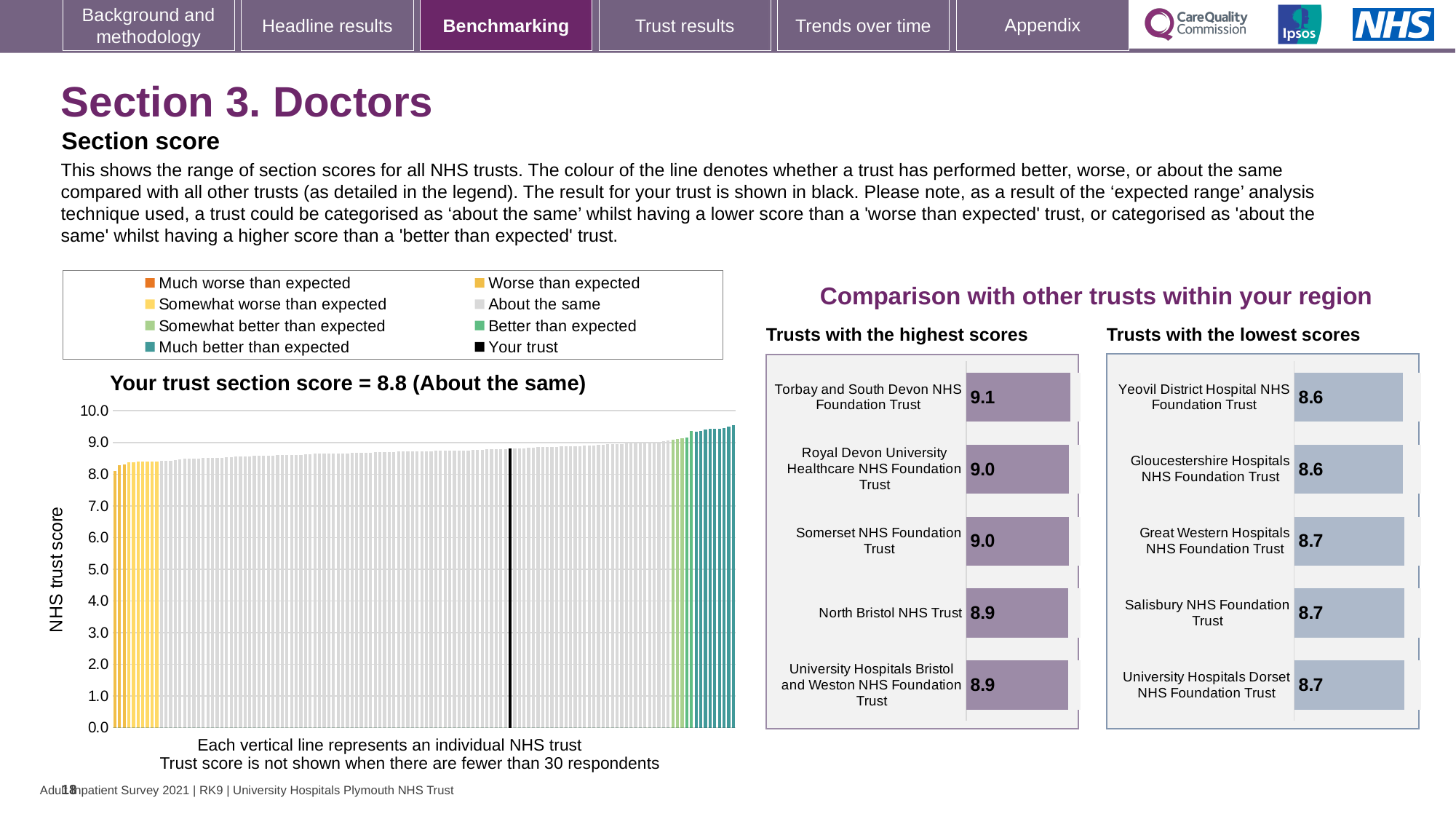
On the 'Trusts with the lowest scores' chart, which is larger, the score for Great Western Hospitals NHS Foundation Trust or Yeovil District Hospital NHS Foundation Trust? Great Western Hospitals NHS Foundation Trust On the 'Trusts with the lowest scores' chart, what is the score for Salisbury NHS Foundation Trust? 8.7 On the 'Trusts with the highest scores' chart, what is the difference between the scores of Torbay and South Devon NHS Foundation Trust and North Bristol NHS Trust? 0.2 On the 'Your trust section score' chart, is the value for your trust (the black line) greater or less than 7.0? greater On the 'Trusts with the highest scores' chart, which trust has the highest score? Torbay and South Devon NHS Foundation Trust On the 'Your trust section score' chart, what is the label on the vertical axis? NHS trust score On the 'Trusts with the highest scores' chart, what is the score for Torbay and South Devon NHS Foundation Trust? 9.1 On the 'Your trust section score' chart, what kind of chart is shown? bar chart On the 'Your trust section score' chart, what is the section score for your trust? 8.8 On the 'Your trust section score' chart, do the trust scores rise or fall from left to right? rise On the 'Trusts with the highest scores' chart, how many trusts are shown? 5 On the 'Your trust section score' chart, how many entries does the legend list? 8